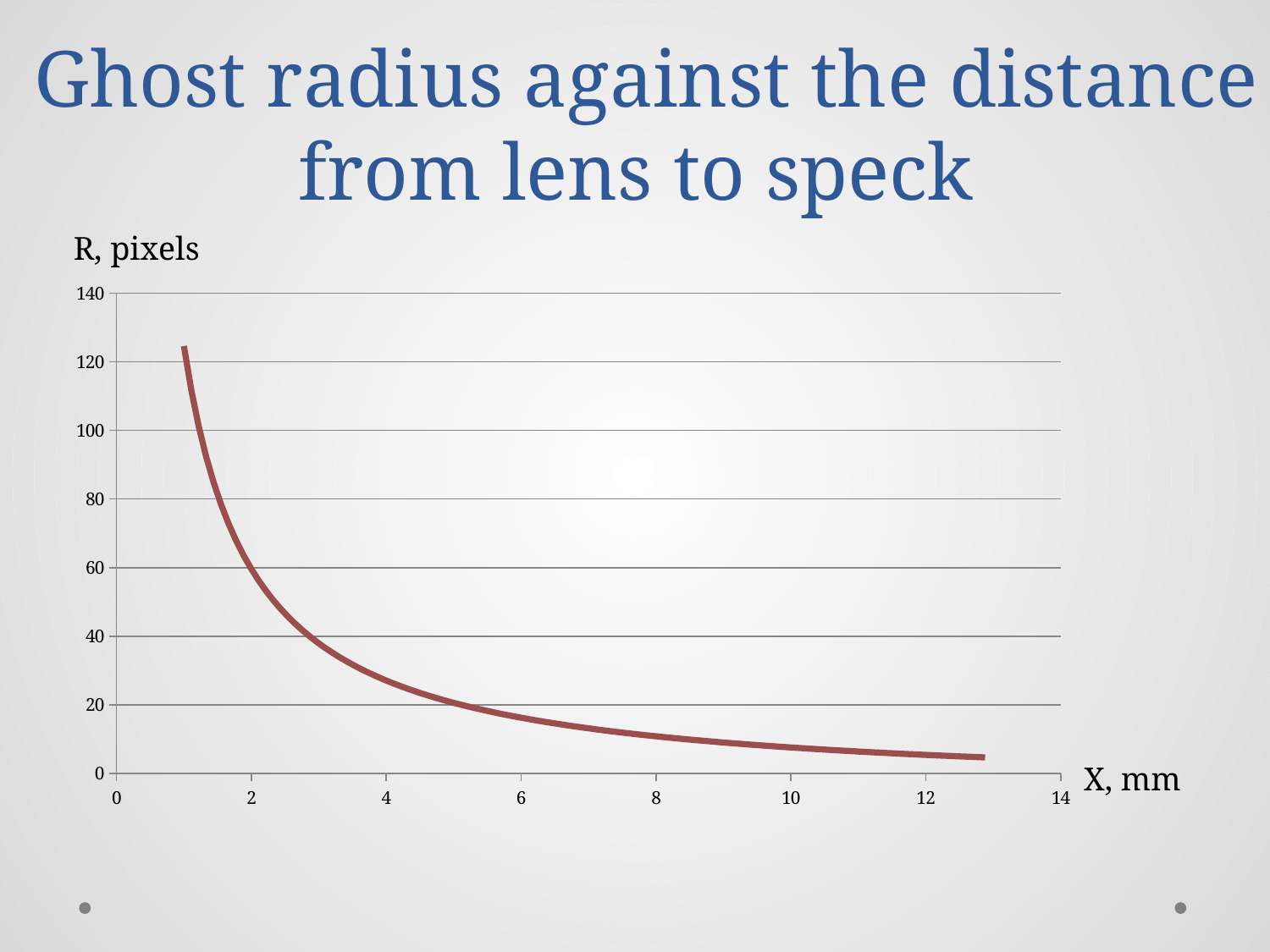
Is the value of R at X = 4 mm greater or less than 20? greater What is the title of the chart? Ghost radius against the distance from lens to speck Is the value of R at X = 8 mm greater or less than 20? less What is the label of the vertical axis? R, pixels What kind of chart is shown on the slide? line chart Is the value of R at X = 4 mm greater or less than 40? less Which is larger, the value of R at X = 2 mm or at X = 10 mm? X = 2 mm Do the values of R rise or fall as X increases along the x axis? fall